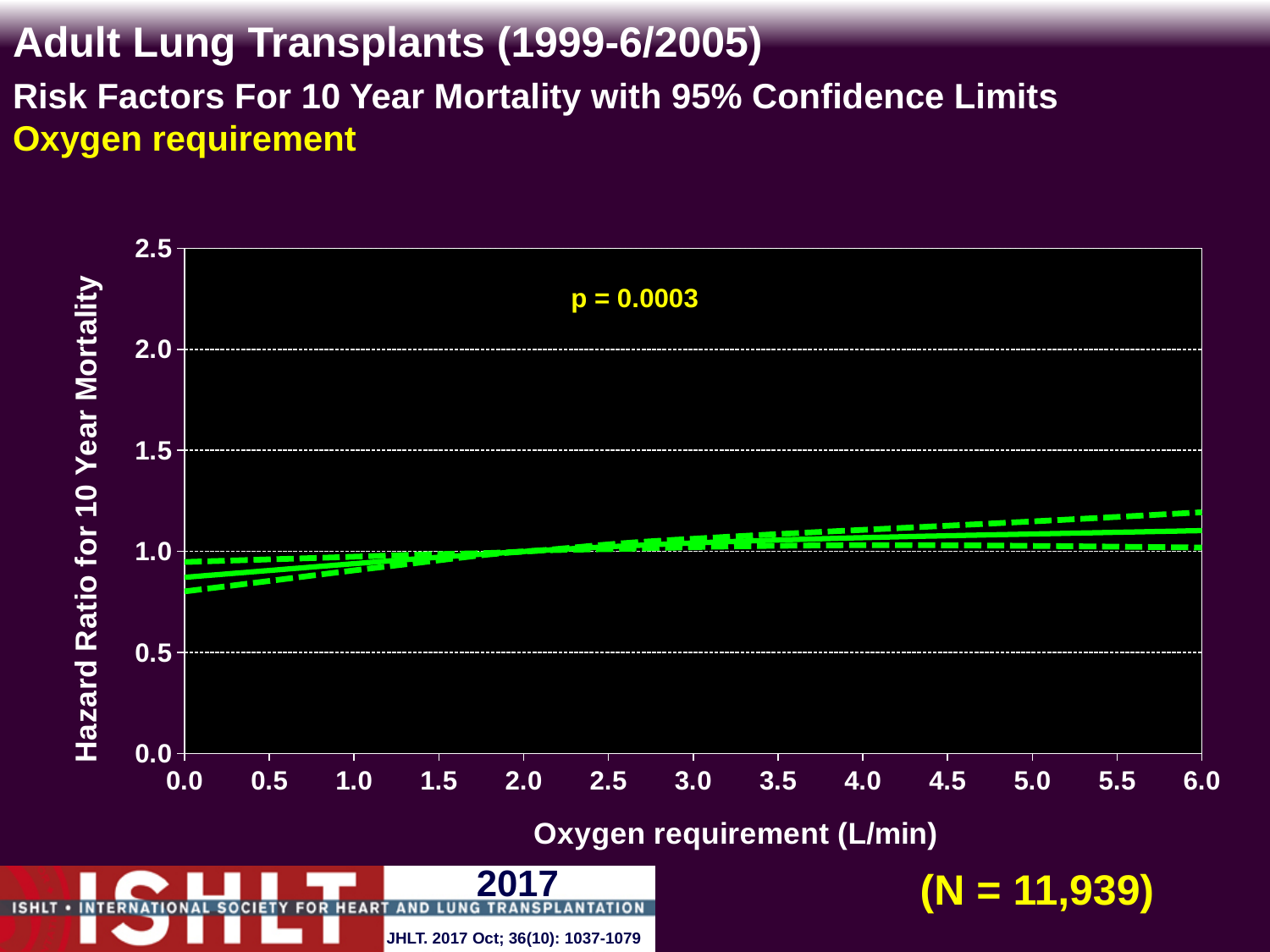
Is the hazard ratio at an oxygen requirement of 0.0 L/min greater or less than 1.0? less Is the upper 95% confidence limit at an oxygen requirement of 6.0 L/min greater or less than 1.0? greater What kind of chart is shown on the slide? line chart Is the hazard ratio at an oxygen requirement of 6.0 L/min greater or less than 1.0? greater Which has the higher hazard ratio: an oxygen requirement of 0.0 L/min or 6.0 L/min? 6.0 L/min Does the hazard ratio for 10 year mortality rise or fall as oxygen requirement increases from 0.0 to 6.0 L/min? rise What sample size (N) is shown on the slide? N = 11,939 What p-value is printed on the chart? p = 0.0003